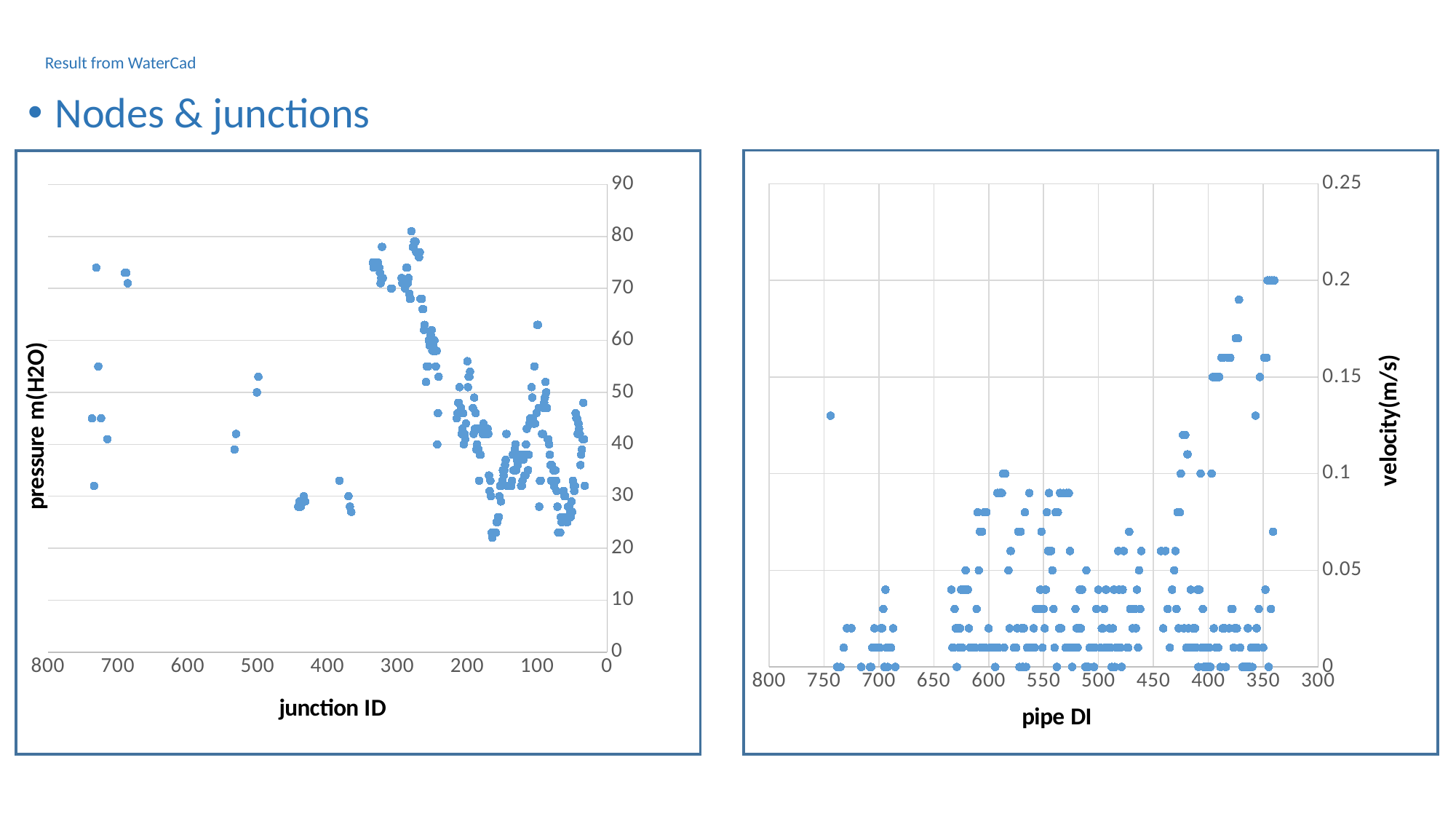
On the right chart, is the velocity of the isolated point near pipe DI 750 greater or less than 0.1? greater On the left chart, what is the title of the vertical axis? pressure m(H2O) On the right chart, is the highest plotted velocity value greater or less than 0.25? less On the left chart, is the pressure of the point near junction ID 100 that sits above the main cluster greater or less than 60? greater What kind of chart is the right chart with x axis 'pipe DI'? scatter chart On the right chart, what is the title of the vertical axis? velocity(m/s) What kind of chart is the left chart with x axis 'junction ID'? scatter chart